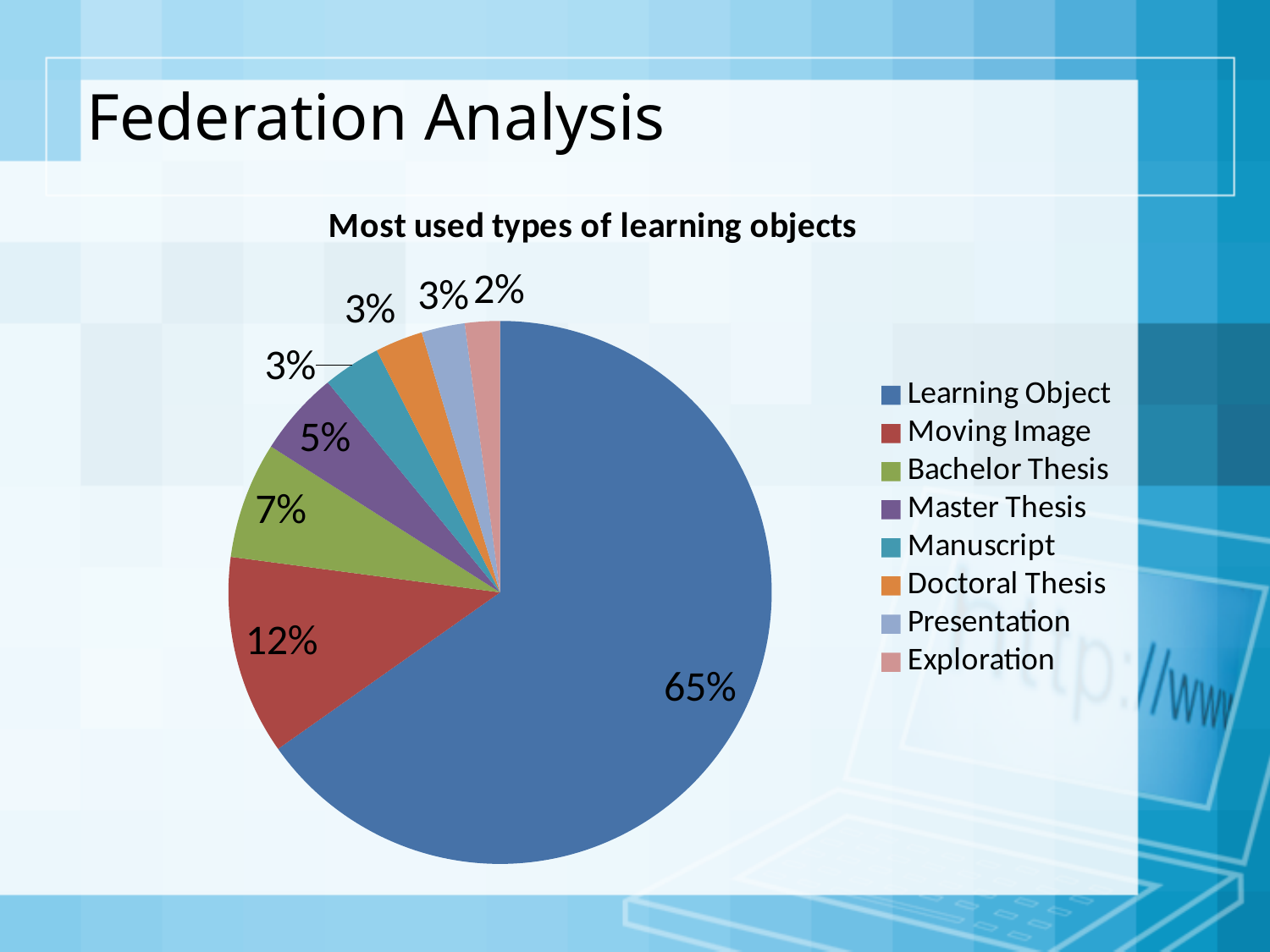
What is the title of the chart? Most used types of learning objects What share of the pie does Bachelor Thesis have? 7% What share of the pie does Master Thesis have? 5% What share of the pie does Learning Object have? 65% What is the difference between the shares of Learning Object and Moving Image? 53% Which has a larger share, Bachelor Thesis or Master Thesis? Bachelor Thesis Which category has the smallest slice of the pie? Exploration What type of chart is shown on the slide? pie chart How many categories does the legend list? 8 Which category has the largest slice of the pie? Learning Object